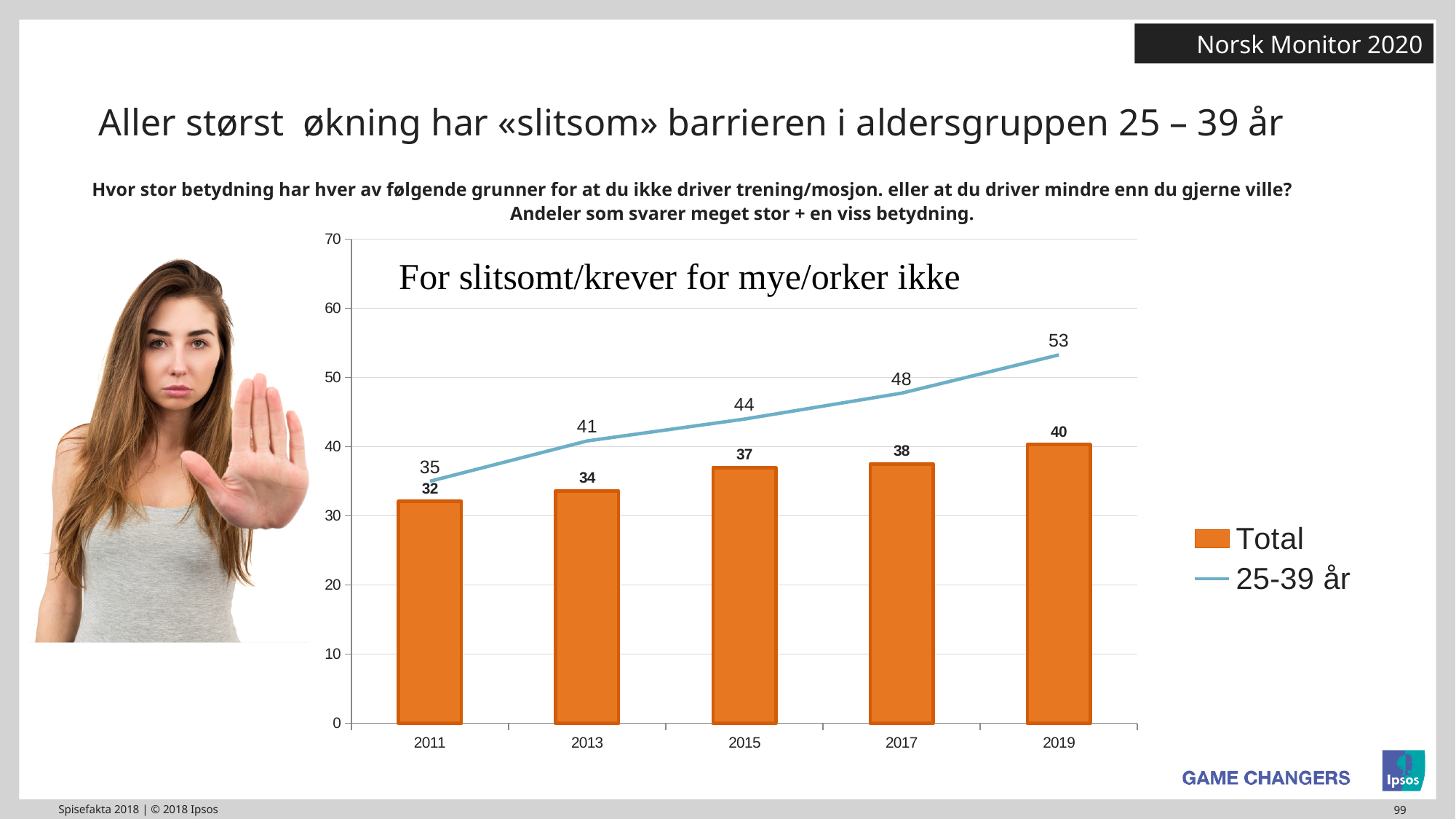
Do the Total values rise or fall from 2011 to 2019? Rise In which year is the 25-39 år series highest? 2019 What is the title printed inside the chart area? For slitsomt/krever for mye/orker ikke In which year is the Total series lowest? 2011 What is the value for Total in 2019? 40 What kind of chart is shown on the slide? Combined bar and line chart How many series does the legend list? 2 How many years are shown on the x axis? 5 What is the value for 25-39 år in 2015? 44 Which is larger in 2013: the Total value or the 25-39 år value? 25-39 år What is the difference between the 25-39 år value and the Total value in 2019? 13 What is the value for Total in 2011? 32